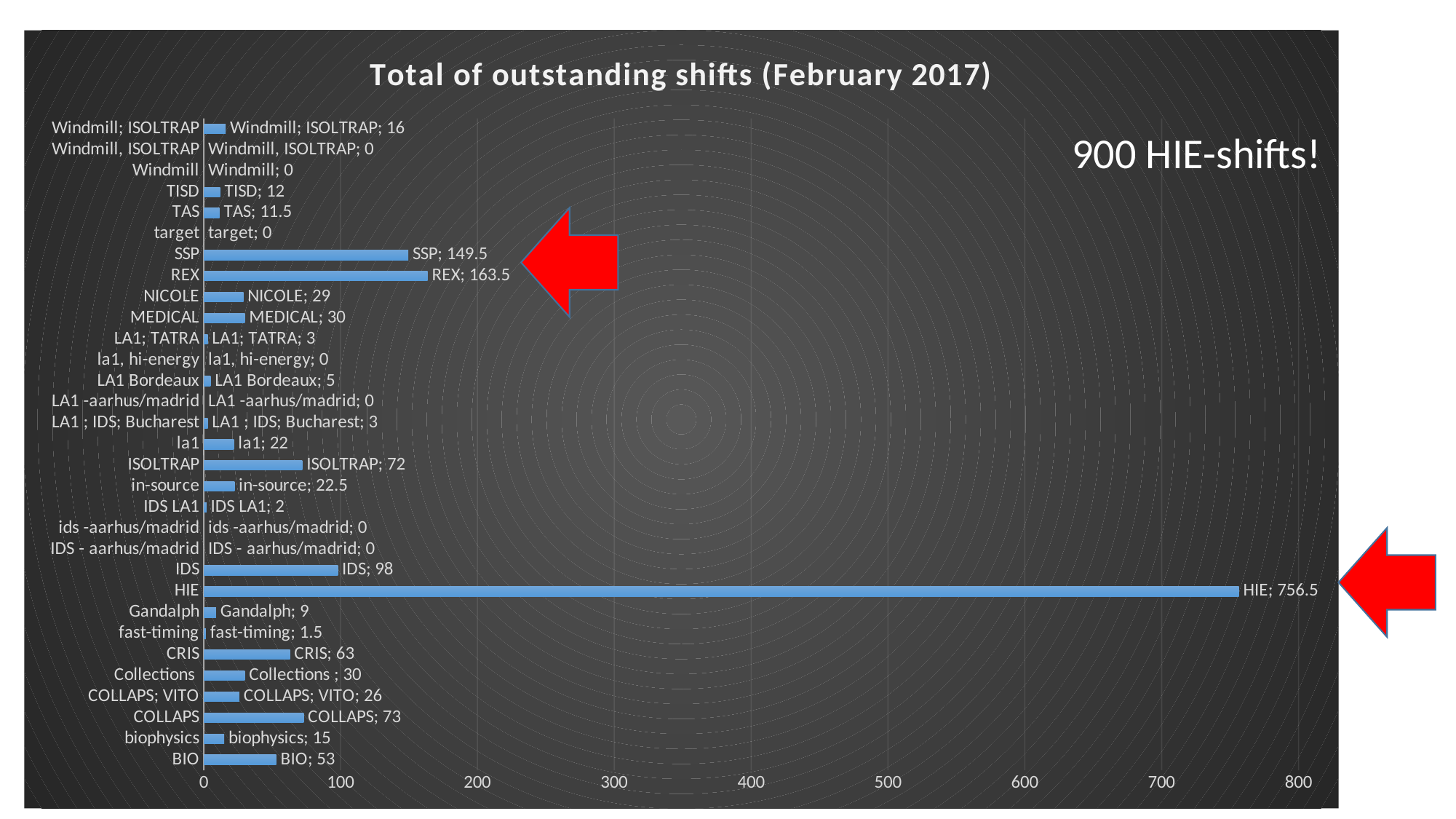
What is the value for ISOLTRAP? 72 What is the difference between the values for HIE and IDS? 658.5 Which is larger, the value for COLLAPS or the value for CRIS? COLLAPS Is the value for IDS greater or less than 100? less What is the value for fast-timing? 1.5 What is the value for HIE? 756.5 What kind of chart is shown on the slide? bar chart How many categories are shown on the chart? 31 What is the title of the chart? Total of outstanding shifts (February 2017) Which category has the highest value? HIE What is the difference between the values for REX and SSP? 14 What is the value for REX? 163.5